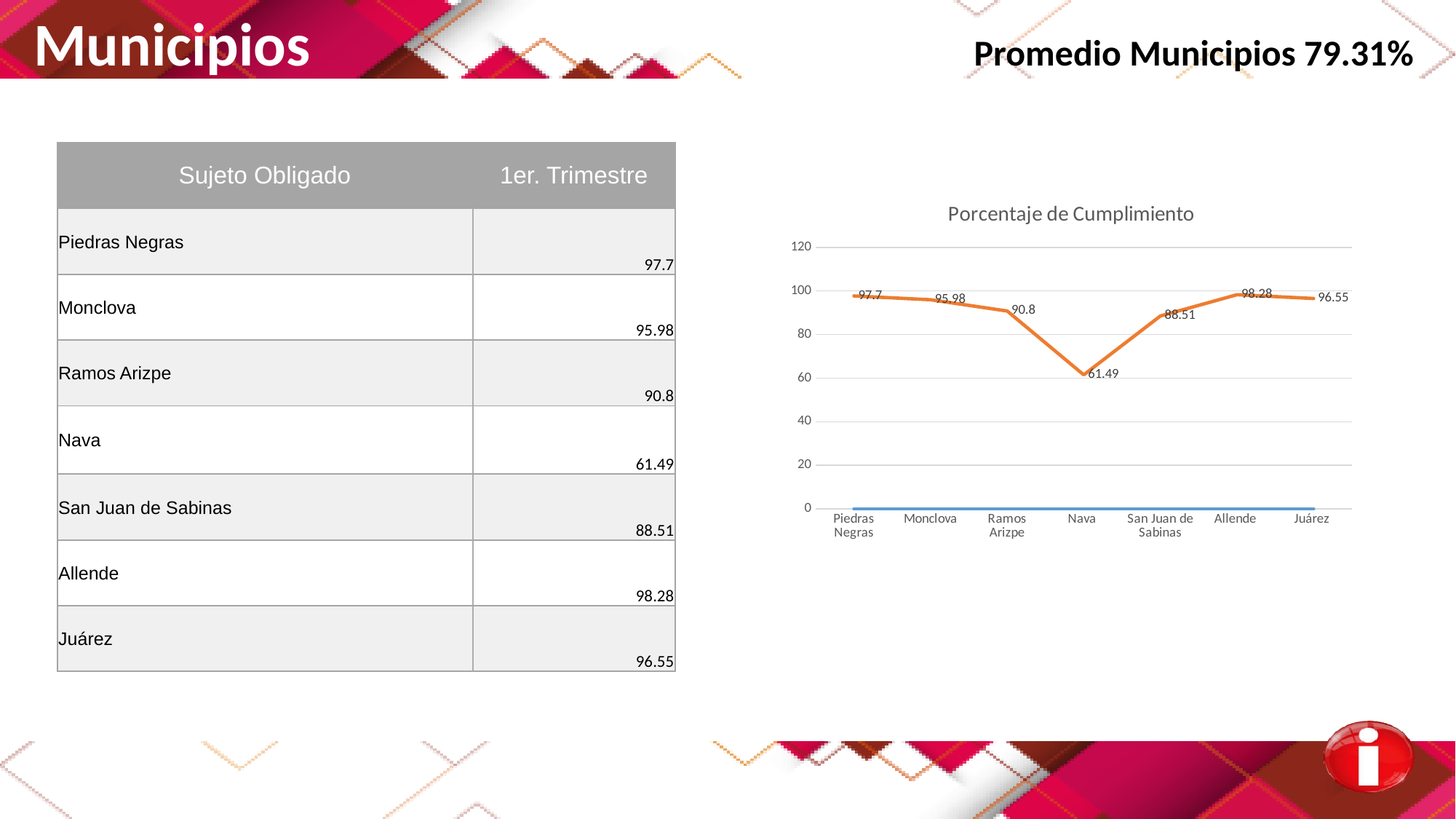
In the Porcentaje de Cumplimiento chart, is the value for Nava greater or less than 80? less Which municipality has the lowest value in the Porcentaje de Cumplimiento chart? Nava What is the value for San Juan de Sabinas in the Porcentaje de Cumplimiento chart? 88.51 What is the difference between the values for Allende and Nava in the Porcentaje de Cumplimiento chart? 36.79 What is the value for Nava in the Porcentaje de Cumplimiento chart? 61.49 In the Porcentaje de Cumplimiento chart, does the value rise or fall from Ramos Arizpe to Nava? fall What kind of chart is the Porcentaje de Cumplimiento chart? line chart Which municipality has the highest value in the Porcentaje de Cumplimiento chart? Allende How many municipalities are plotted along the x axis of the Porcentaje de Cumplimiento chart? 7 In the Porcentaje de Cumplimiento chart, which is larger, the value for Ramos Arizpe or the value for San Juan de Sabinas? Ramos Arizpe What is the difference between the values for Piedras Negras and Monclova in the Porcentaje de Cumplimiento chart? 1.72 What is the value for Allende in the Porcentaje de Cumplimiento chart? 98.28